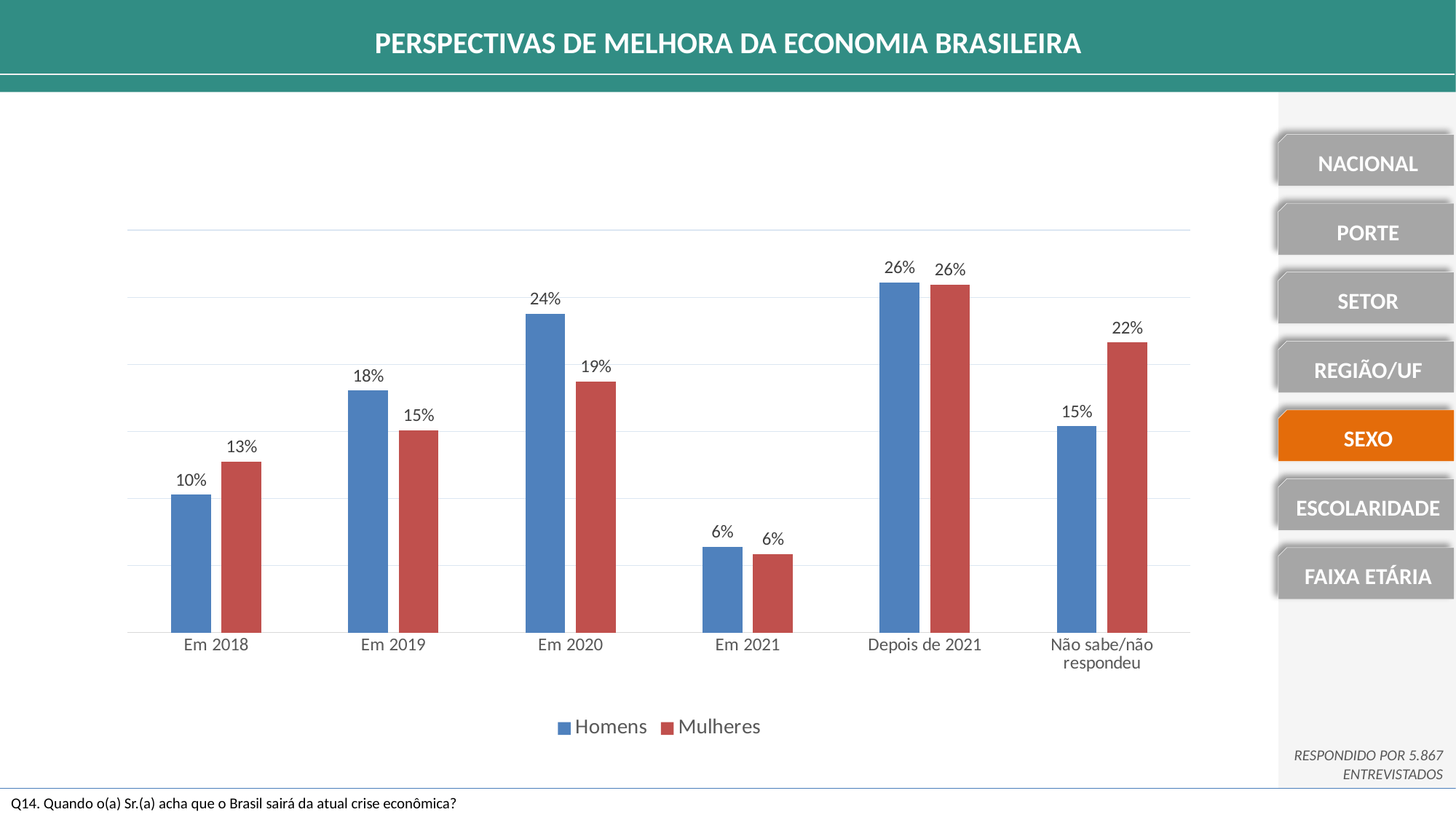
Which category has the highest value for Homens? Depois de 2021 What kind of chart is shown on the slide? Bar chart How many series does the legend list? 2 What is the difference between Homens and Mulheres in Em 2020? 5% What is the difference between Mulheres and Homens in Não sabe/não respondeu? 7% Which is larger in Em 2019, Homens or Mulheres? Homens What is the value for Mulheres in Não sabe/não respondeu? 22% Which category has the lowest value for Mulheres? Em 2021 What is the value for Homens in Em 2020? 24% How many categories are shown on the x axis? 6 What is the value for Mulheres in Em 2018? 13% What are the two series listed in the legend? Homens and Mulheres